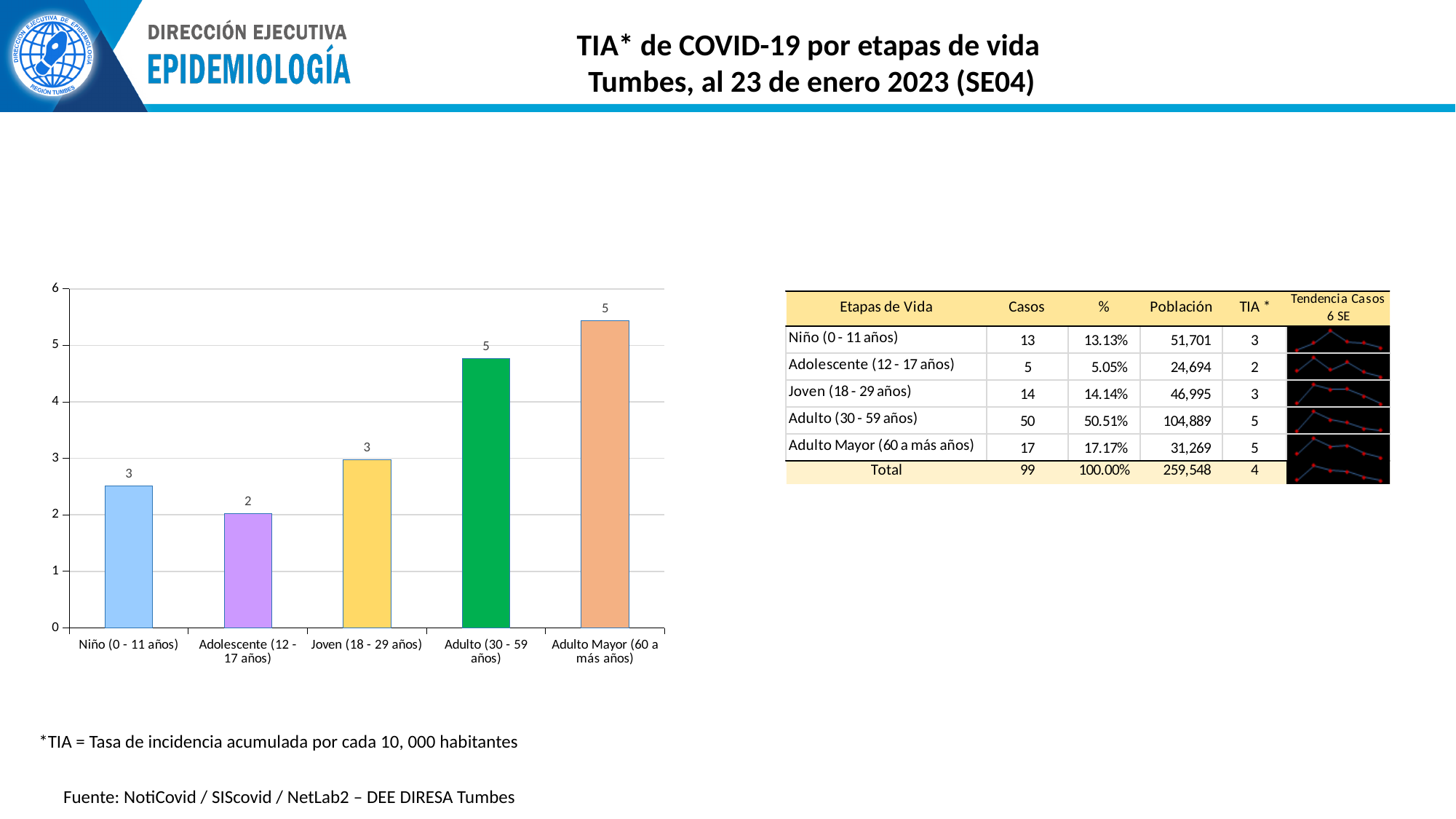
What is the TIA value shown for Adolescente (12 - 17 años) in the bar chart? 2 What is the difference between the labelled values for Adulto (30 - 59 años) and Adolescente (12 - 17 años)? 3 Do the bars rise or fall from Joven (18 - 29 años) to Adulto (30 - 59 años)? Rise What is the TIA value shown for Niño (0 - 11 años) in the bar chart? 3 What is the TIA value shown for Adulto (30 - 59 años) in the bar chart? 5 How many age groups are plotted in the bar chart? 5 Is the bar for Niño (0 - 11 años) greater or less than 2? greater Which has a larger value in the bar chart, Niño (0 - 11 años) or Adolescente (12 - 17 años)? Niño (0 - 11 años) Which age group has the lowest bar in the chart? Adolescente (12 - 17 años) What colour is the bar for Adulto (30 - 59 años)? Green What kind of chart is used to show the TIA by age group? Bar chart